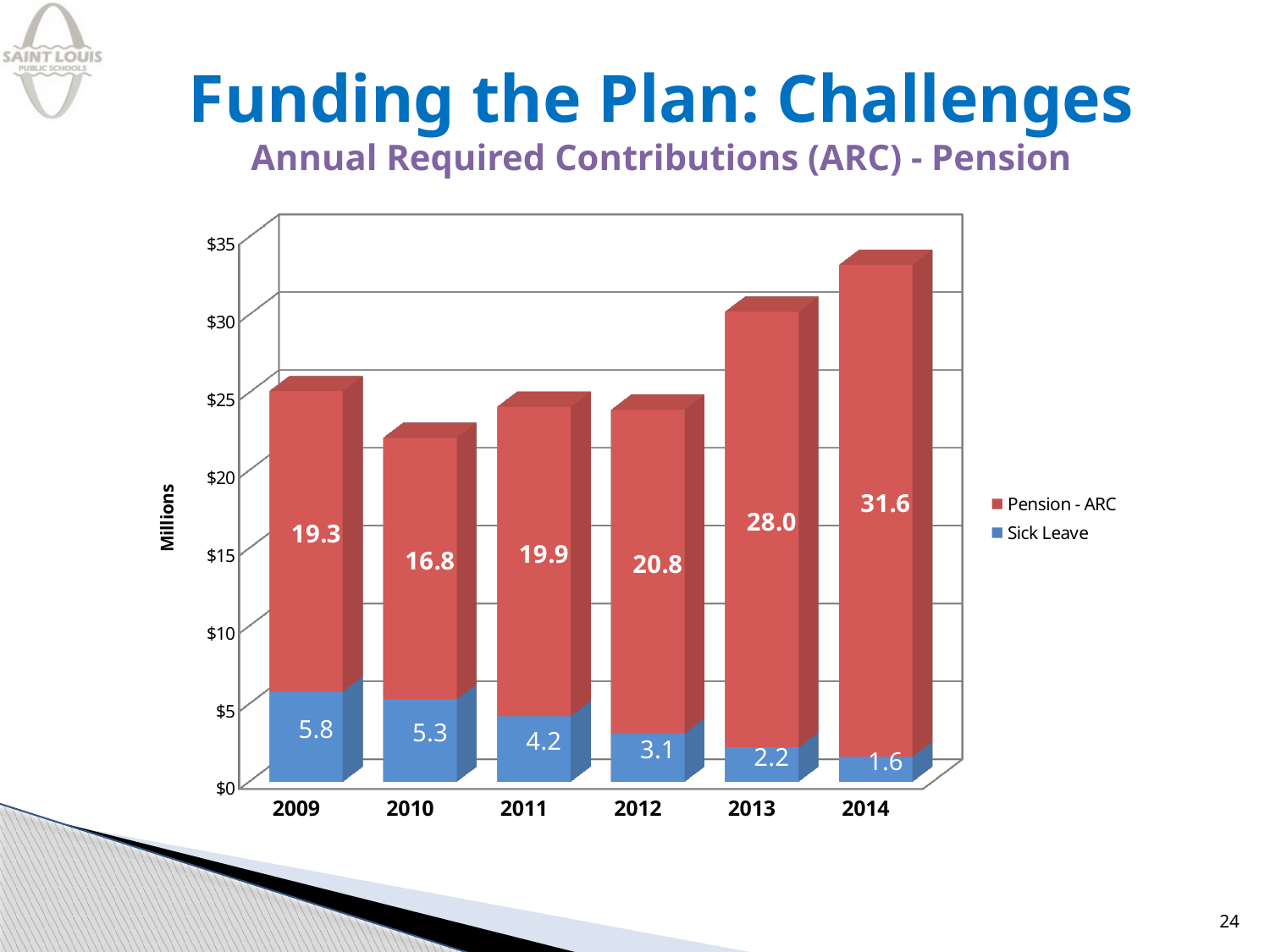
Is the total stacked bar for 2013 greater or less than $25? greater Which is larger, the Sick Leave value for 2009 or for 2010? 2009 What is the Pension - ARC value for 2013? 28.0 Which year has the lowest Sick Leave value? 2014 What kind of chart is shown on the slide? stacked bar chart Which year has the highest Pension - ARC value? 2014 What is the Sick Leave value for 2011? 4.2 What is the total of the stacked bar for 2014? 33.2 What is the label on the vertical axis? Millions How many years are shown on the x axis? 6 How many series does the legend list? 2 What is the difference between the Pension - ARC values for 2014 and 2013? 3.6